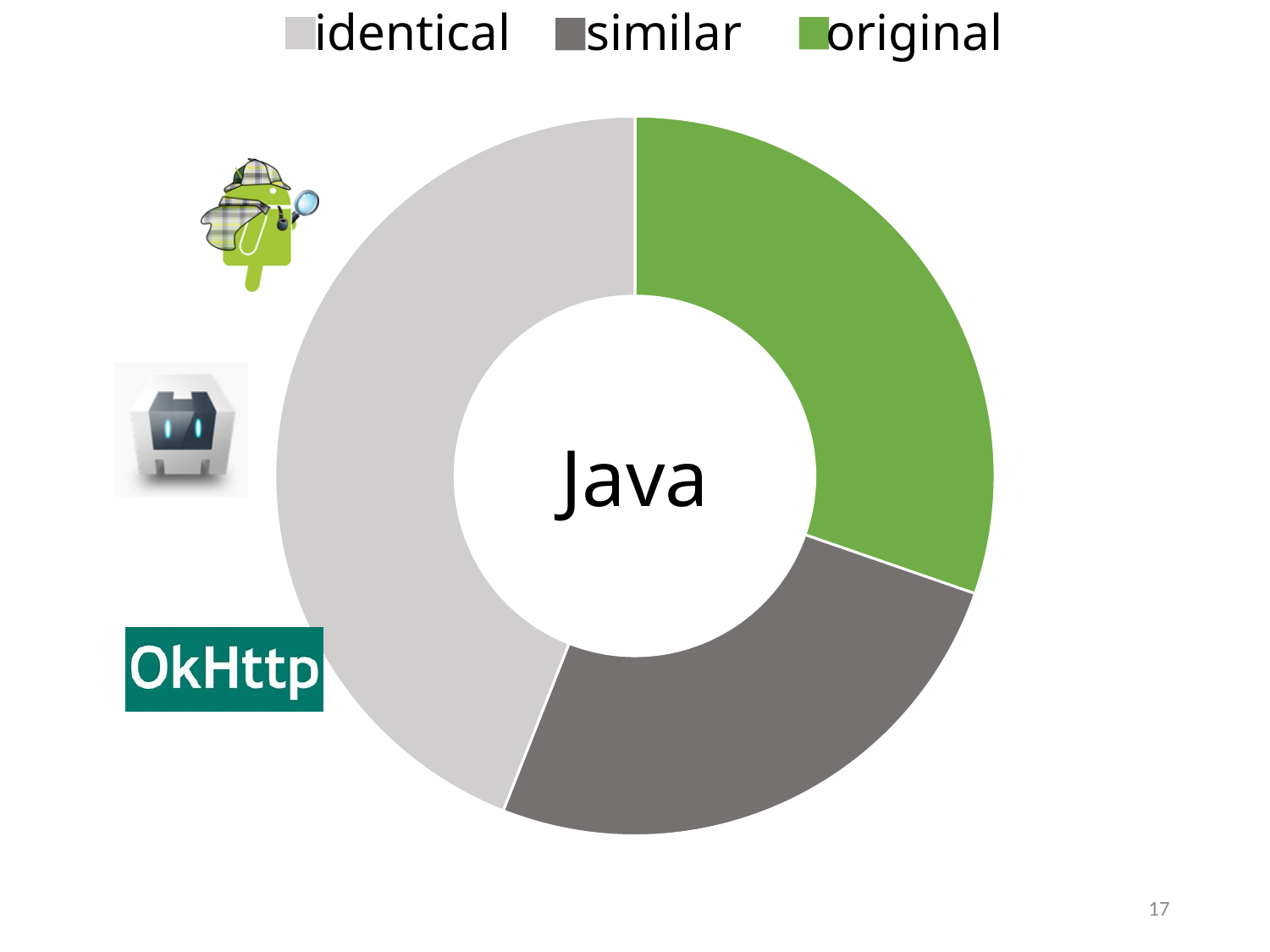
Which category takes up the smallest share of the doughnut chart? similar Which is larger, the share for identical or the share for similar? identical What text is shown in the centre of the doughnut chart? Java Which category is shown in green in the doughnut chart? original What kind of chart is shown on the slide? doughnut chart How many categories does the doughnut chart have? 3 Which is larger, the share for identical or the share for original? identical Which category takes up the largest share of the doughnut chart? identical How many entries does the legend list? 3